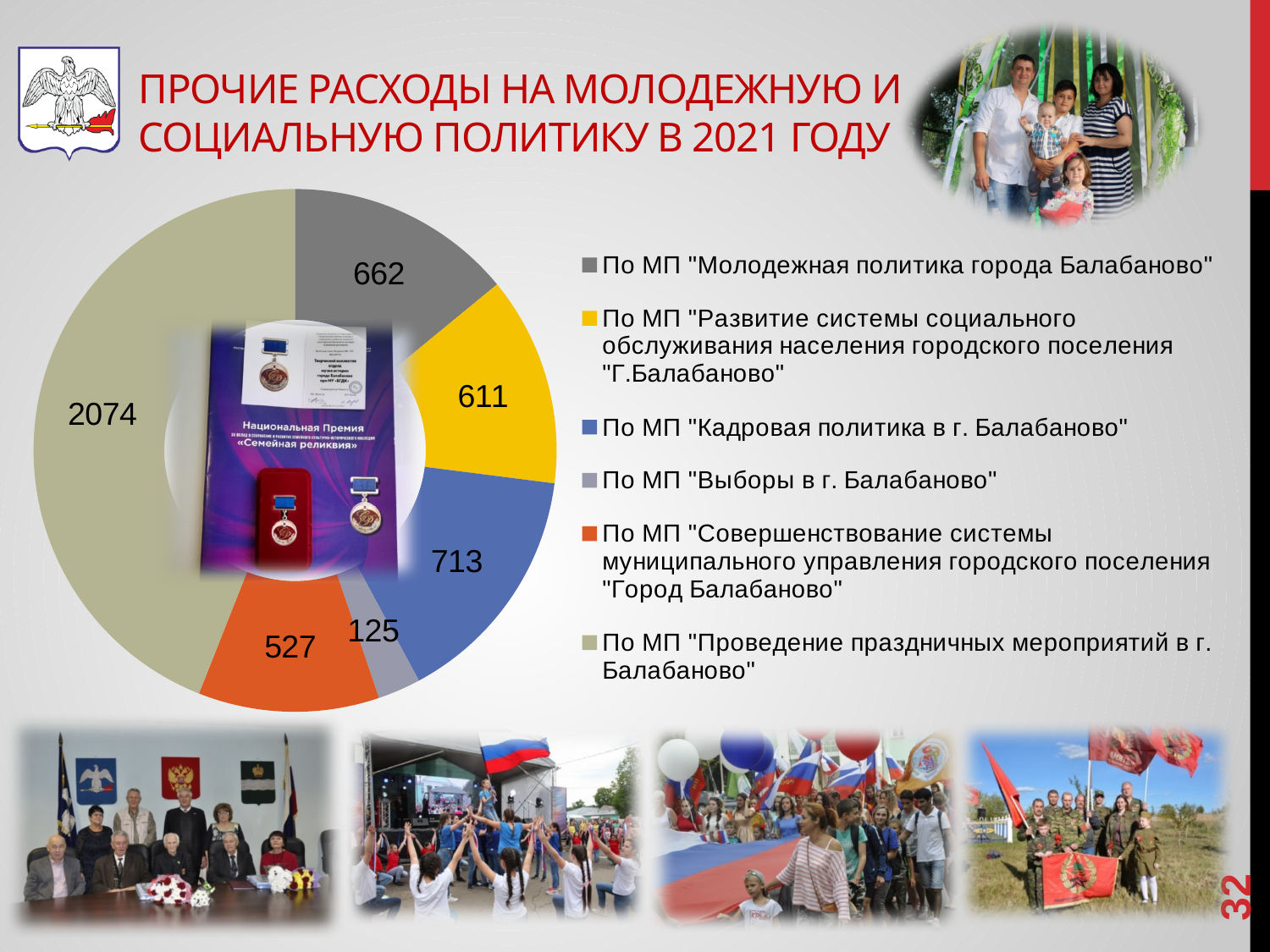
What colour is the slice for "По МП "Кадровая политика в г. Балабаново""? Blue Which category has the largest value in the chart? По МП "Проведение праздничных мероприятий в г. Балабаново" Which category has the smallest value in the chart? По МП "Выборы в г. Балабаново" Which is larger: the value for "Развитие системы социального обслуживания населения" or the value for "Совершенствование системы муниципального управления"? По МП "Развитие системы социального обслуживания населения городского поселения "Г.Балабаново"" What value is shown for the slice "По МП "Молодежная политика города Балабаново""? 662 What value is shown for the slice "По МП "Выборы в г. Балабаново""? 125 What value is shown for the slice "По МП "Кадровая политика в г. Балабаново""? 713 What is the difference between the values for "Кадровая политика в г. Балабаново" and "Молодежная политика города Балабаново"? 51 What kind of chart is shown on the slide? Doughnut chart What value is shown for the slice "По МП "Проведение праздничных мероприятий в г. Балабаново""? 2074 How many categories does the chart show? 6 What is the total of all the values shown in the chart? 4712